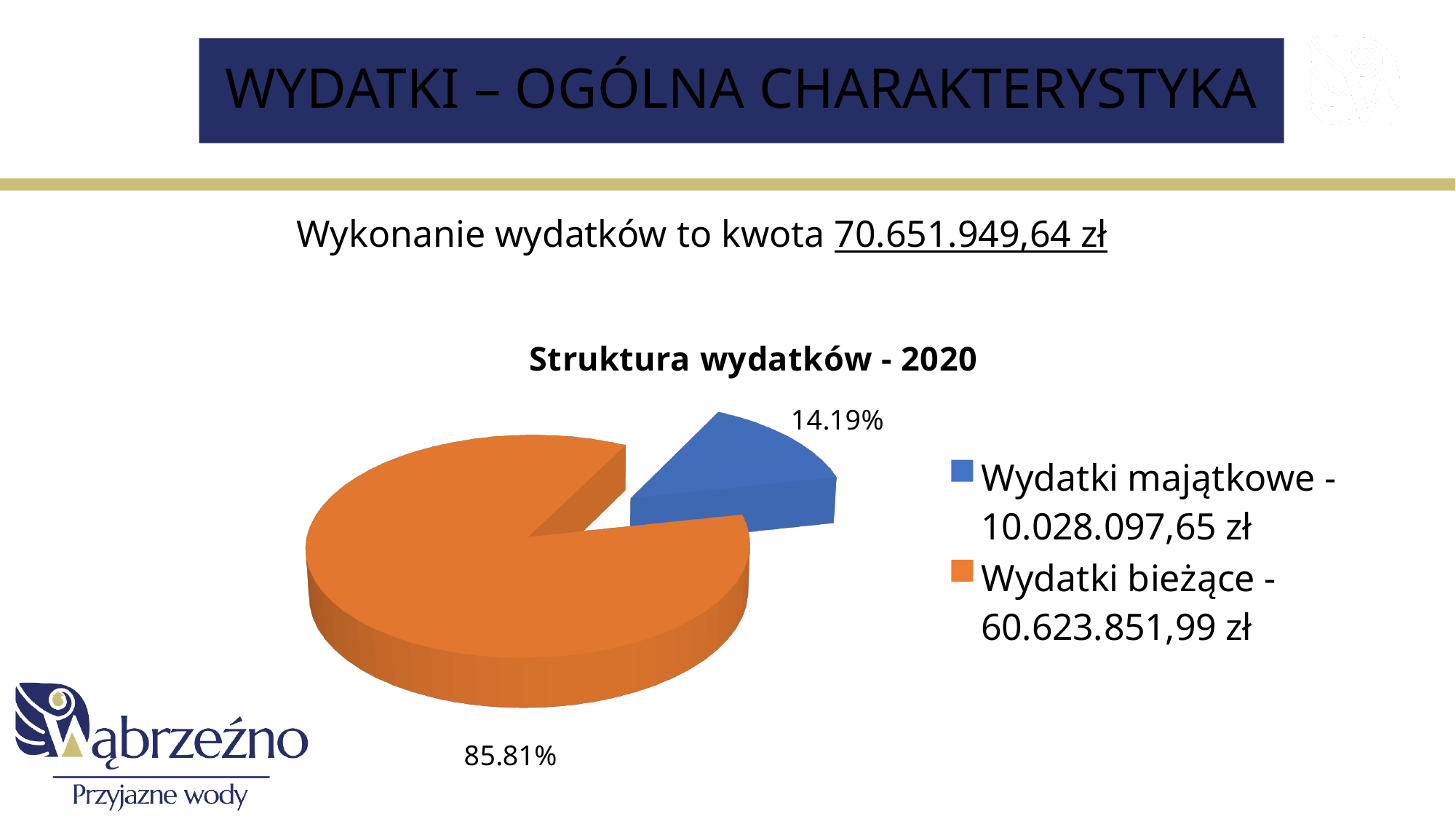
What amount is given in the legend for Wydatki majątkowe? 10.028.097,65 zł What share of the pie is Wydatki majątkowe? 14.19% What share of the pie is Wydatki bieżące? 85.81% What colour is the Wydatki majątkowe slice? Blue What is the difference in percentage points between the Wydatki bieżące and Wydatki majątkowe slices? 71.62% How many slices does the pie chart have? 2 What is the title of the chart? Struktura wydatków - 2020 How many entries does the legend list? 2 Which slice is the smallest in the pie chart? Wydatki majątkowe What amount is given in the legend for Wydatki bieżące? 60.623.851,99 zł Which slice is the largest in the pie chart? Wydatki bieżące What kind of chart is shown on the slide? Pie chart